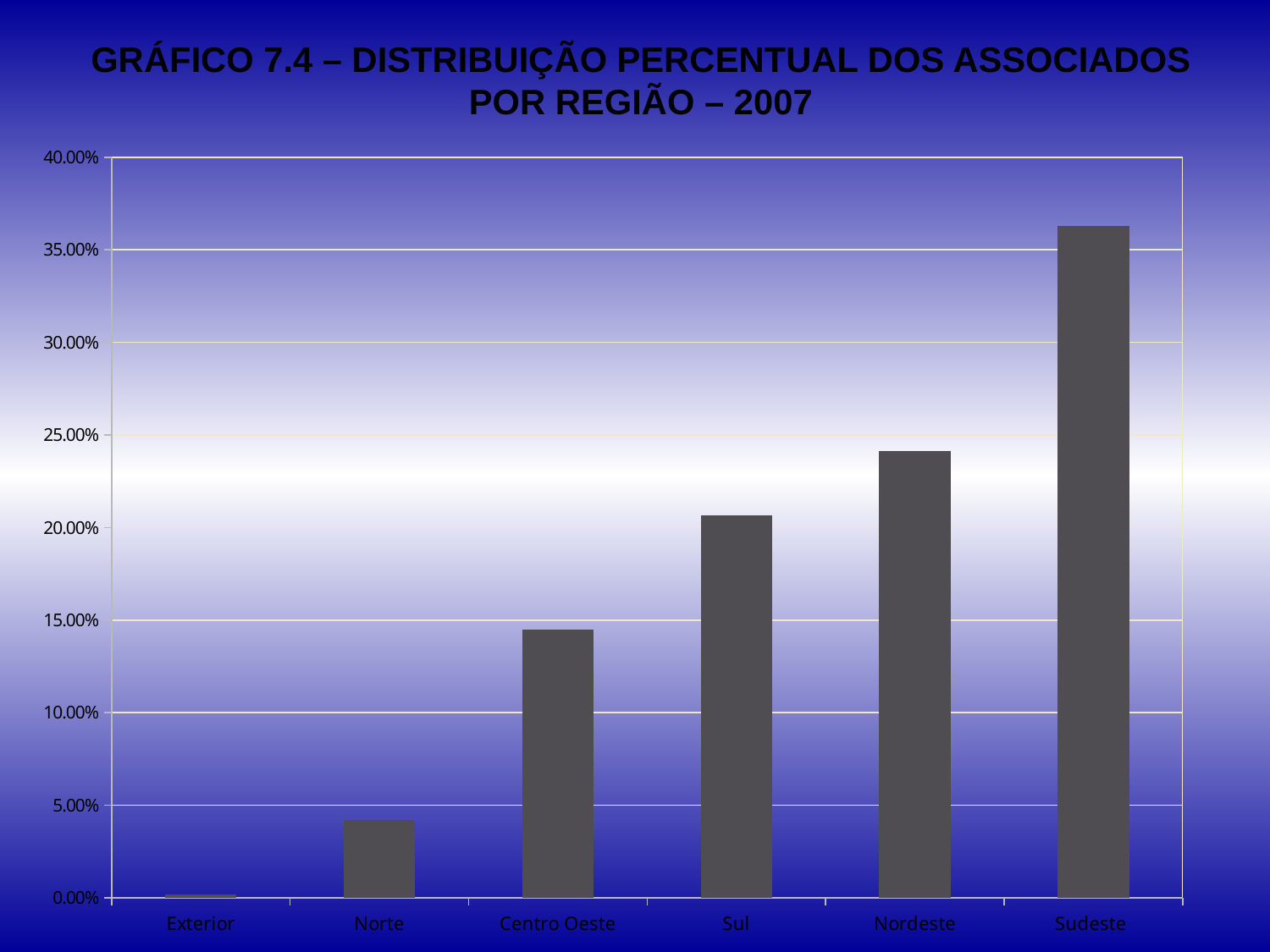
Is the value for Sul greater or less than 20.00%? greater Is the value for Sudeste greater or less than 35.00%? greater Is the value for Centro Oeste greater or less than 15.00%? less Do the values rise or fall moving from left to right along the x axis? rise What kind of chart is shown on the slide? bar chart How many regions (categories) are shown on the x axis? 6 Which is larger, the value for Nordeste or the value for Sul? Nordeste Which region has the highest percentage of associates? Sudeste What is the title of the chart? GRÁFICO 7.4 – DISTRIBUIÇÃO PERCENTUAL DOS ASSOCIADOS POR REGIÃO – 2007 Which category has the lowest percentage of associates? Exterior